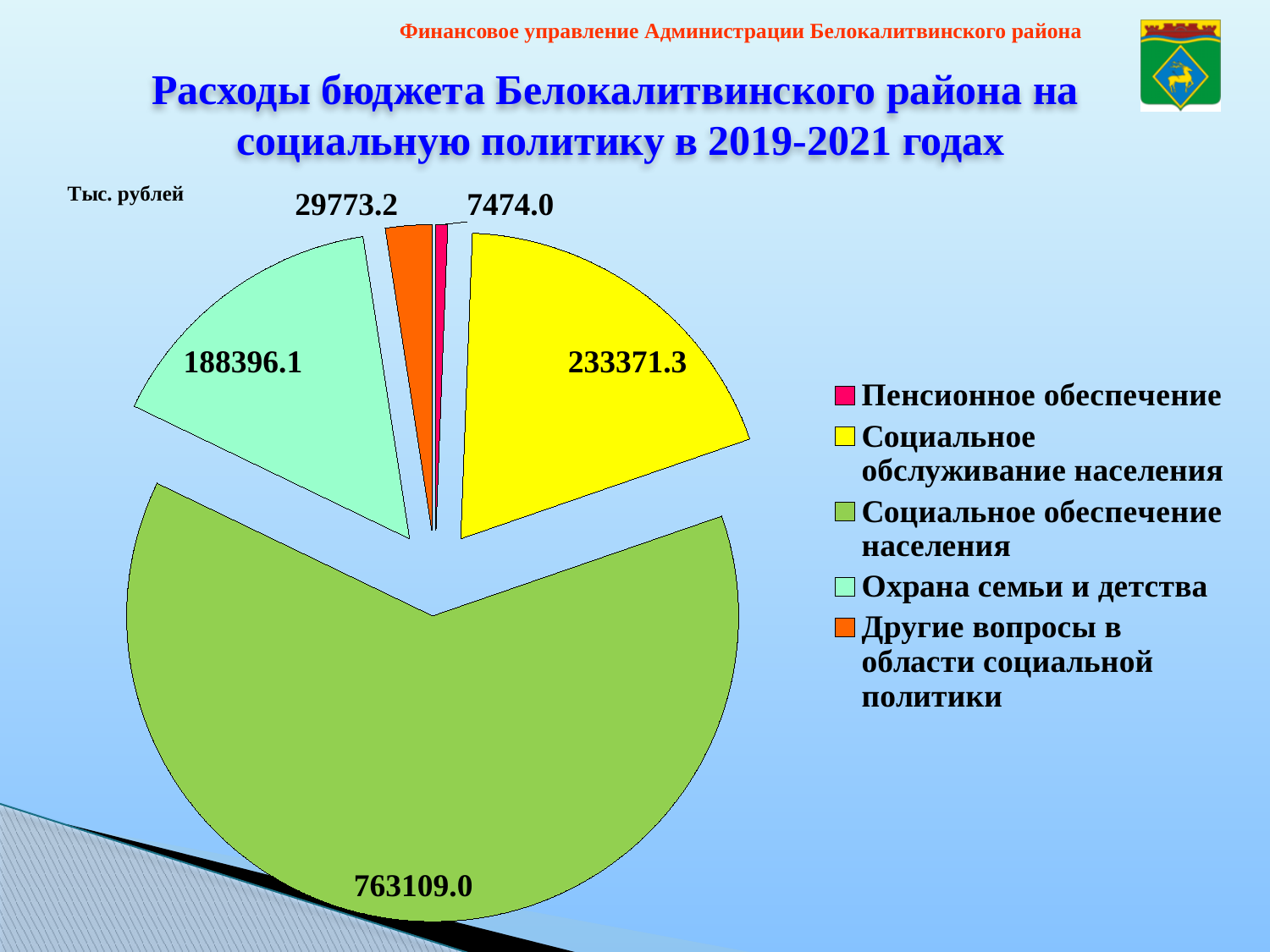
What is the value for Социальное обеспечение населения? 763109.0 What is the total of all slices in the pie chart? 1222123.6 Which category has the largest value? Социальное обеспечение населения What is the value for Охрана семьи и детства? 188396.1 What type of chart is shown on the slide? pie chart What is the value for Пенсионное обеспечение? 7474.0 What colour is the slice for Социальное обслуживание населения? yellow Which is larger: Другие вопросы в области социальной политики or Пенсионное обеспечение? Другие вопросы в области социальной политики Which category has the smallest value? Пенсионное обеспечение How many slices does the pie chart have? 5 What is the difference between Социальное обслуживание населения and Охрана семьи и детства? 44975.2 What is the value for Другие вопросы в области социальной политики? 29773.2